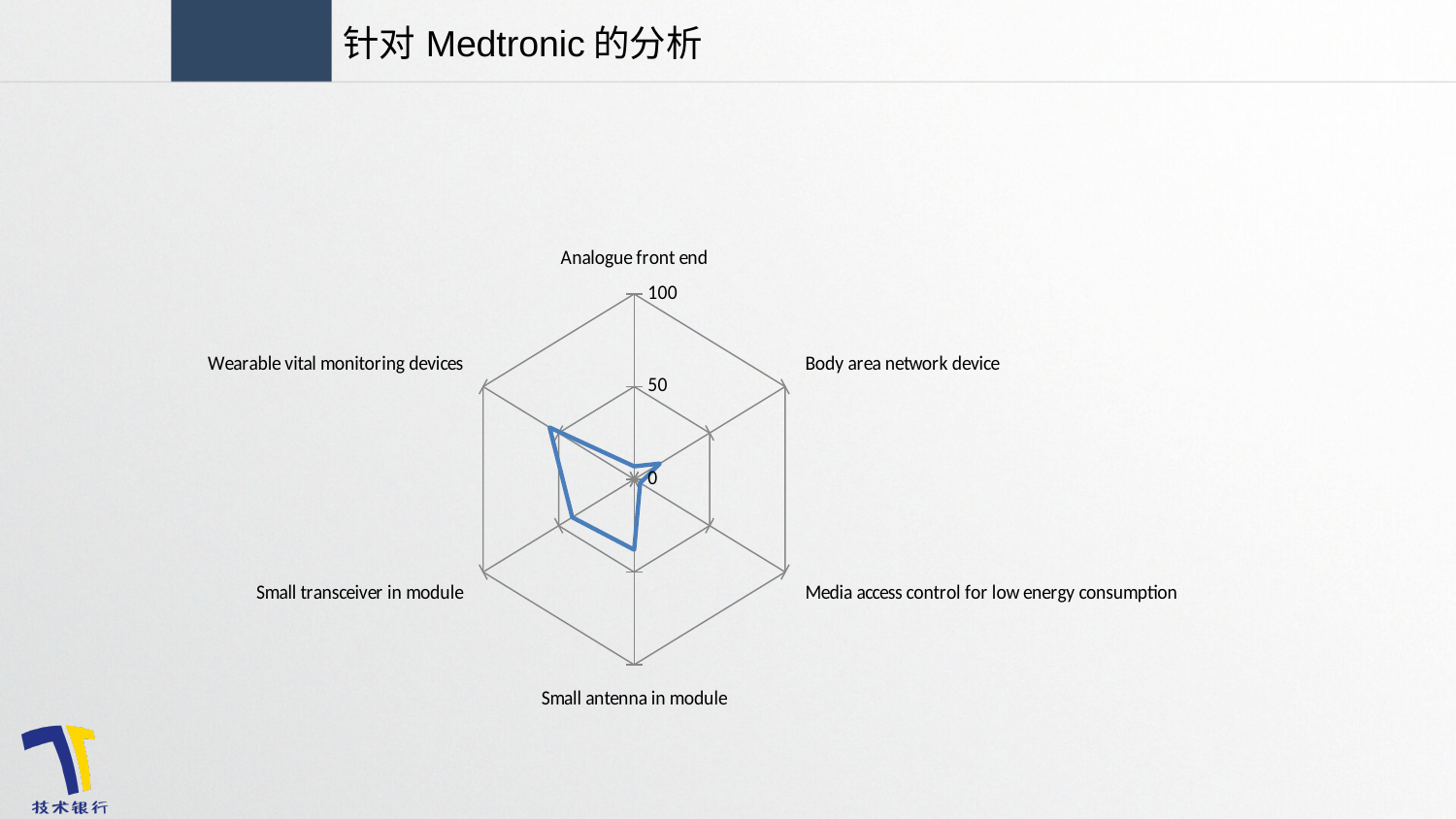
Which is larger, the value for Small antenna in module or the value for Analogue front end? Small antenna in module Is the value for Body area network device greater or less than 50? less Which is larger, the value for Wearable vital monitoring devices or the value for Body area network device? Wearable vital monitoring devices Is the value for Small antenna in module greater or less than 50? less Is the value for Analogue front end greater or less than 50? less How many categories (axes) does the radar chart have? 6 What is the maximum value shown on the radar chart's axis scale? 100 What kind of chart is shown on the slide? Radar chart Which category has the highest value on the radar chart? Wearable vital monitoring devices What is the title of the slide containing the radar chart? 针对 Medtronic 的分析